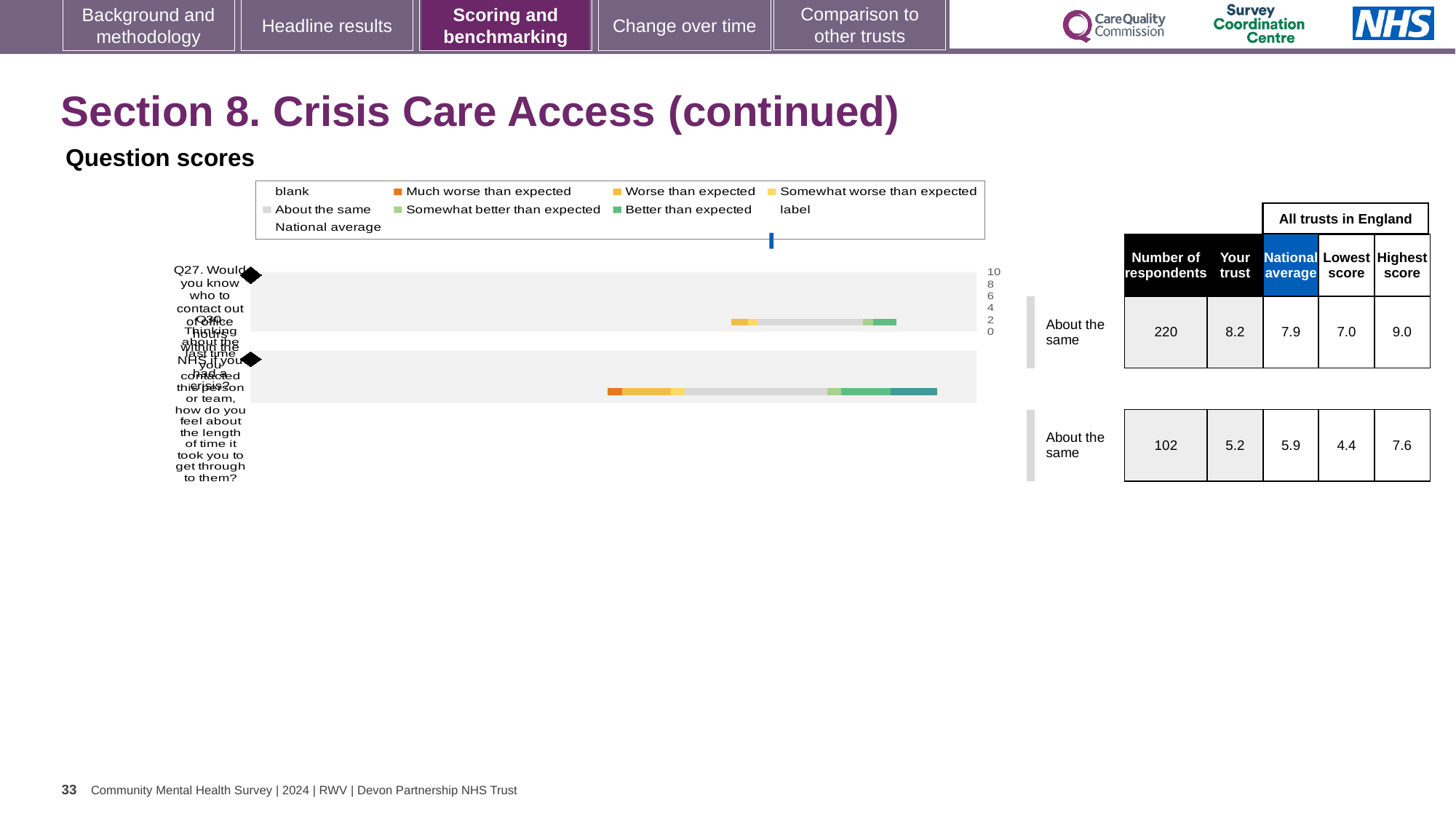
What is the difference between the 'Your trust' score and the national average for Q30? 0.7 What kind of chart is shown under 'Question scores'? bar chart Which question has the higher 'Your trust' score, Q27 or Q30? Q27 What is the maximum value shown on the chart's score axis? 10 In the table beside the chart, what is the 'Your trust' score for Q27? 8.2 How many questions (bars) are plotted in the Question scores chart? 2 In the table beside the chart, what is the highest score across all trusts in England for Q30? 7.6 What benchmark category is shown next to the chart for both Q27 and Q30? About the same In the table beside the chart, how many respondents answered Q30? 102 In the table beside the chart, what is the national average for Q27? 7.9 In the table beside the chart, what is the lowest score across all trusts in England for Q27? 7.0 In the table beside the chart, what is the 'Your trust' score for Q30? 5.2